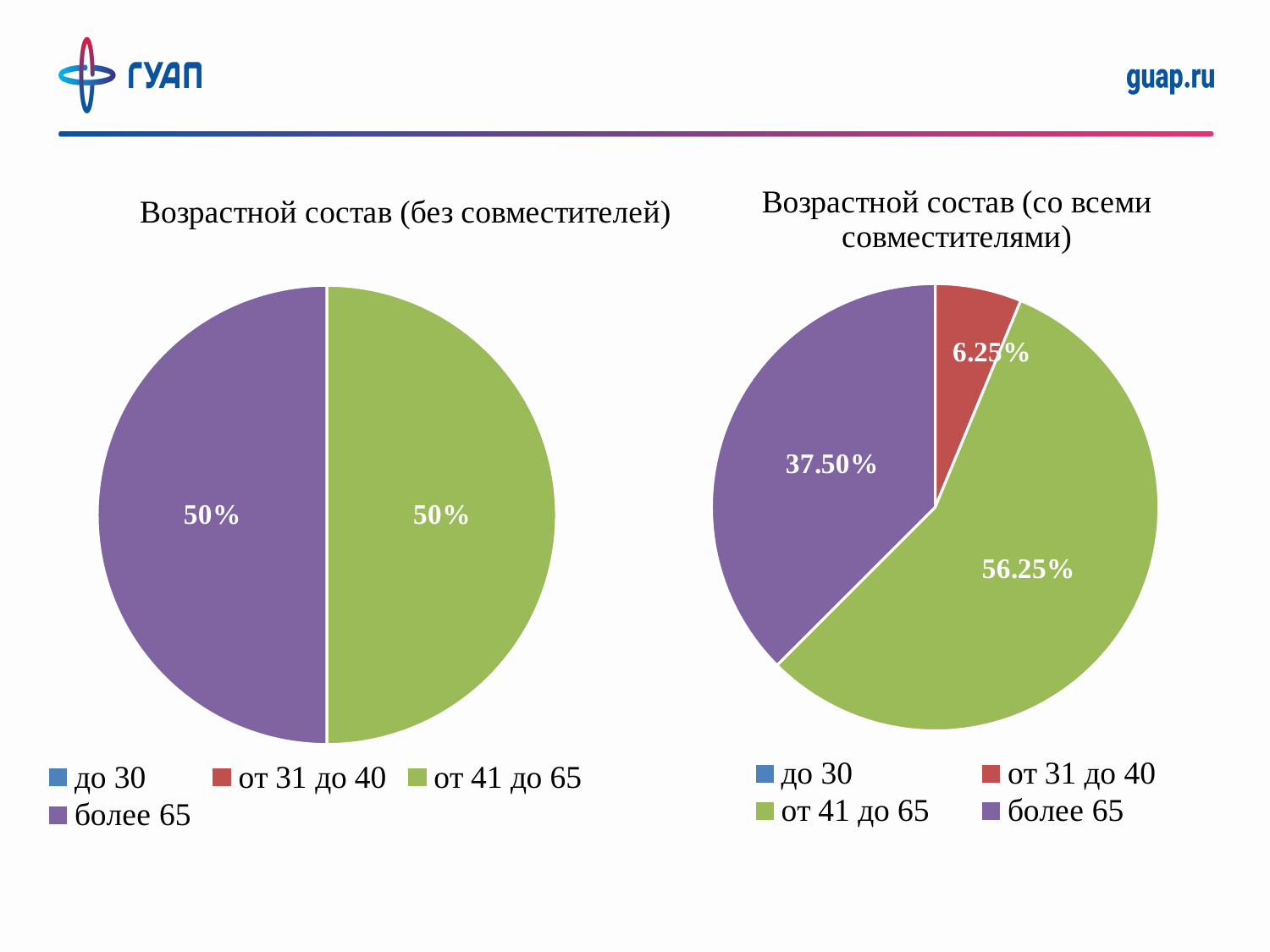
In the chart "Возрастной состав (со всеми совместителями)", which is larger: the "более 65" slice or the "от 31 до 40" slice? более 65 In the chart "Возрастной состав (без совместителей)", what share does the "более 65" slice have? 50% In the chart "Возрастной состав (со всеми совместителями)", which labelled slice is the smallest? от 31 до 40 In the chart "Возрастной состав (со всеми совместителями)", what share does the "от 31 до 40" slice have? 6.25% In the chart "Возрастной состав (со всеми совместителями)", what is the difference between the "от 41 до 65" share and the "более 65" share? 18.75% How many entries does the legend of the right chart "Возрастной состав (со всеми совместителями)" list? 4 In the chart "Возрастной состав (со всеми совместителями)", what share does the "более 65" slice have? 37.50% In the chart "Возрастной состав (со всеми совместителями)", which category has the largest slice? от 41 до 65 In the chart "Возрастной состав (со всеми совместителями)", what colour is the "от 31 до 40" slice? red In the chart "Возрастной состав (со всеми совместителями)", what share does the "от 41 до 65" slice have? 56.25% In the chart "Возрастной состав (без совместителей)", what share does the "от 41 до 65" slice have? 50% What kind of chart is the left chart titled "Возрастной состав (без совместителей)"? pie chart